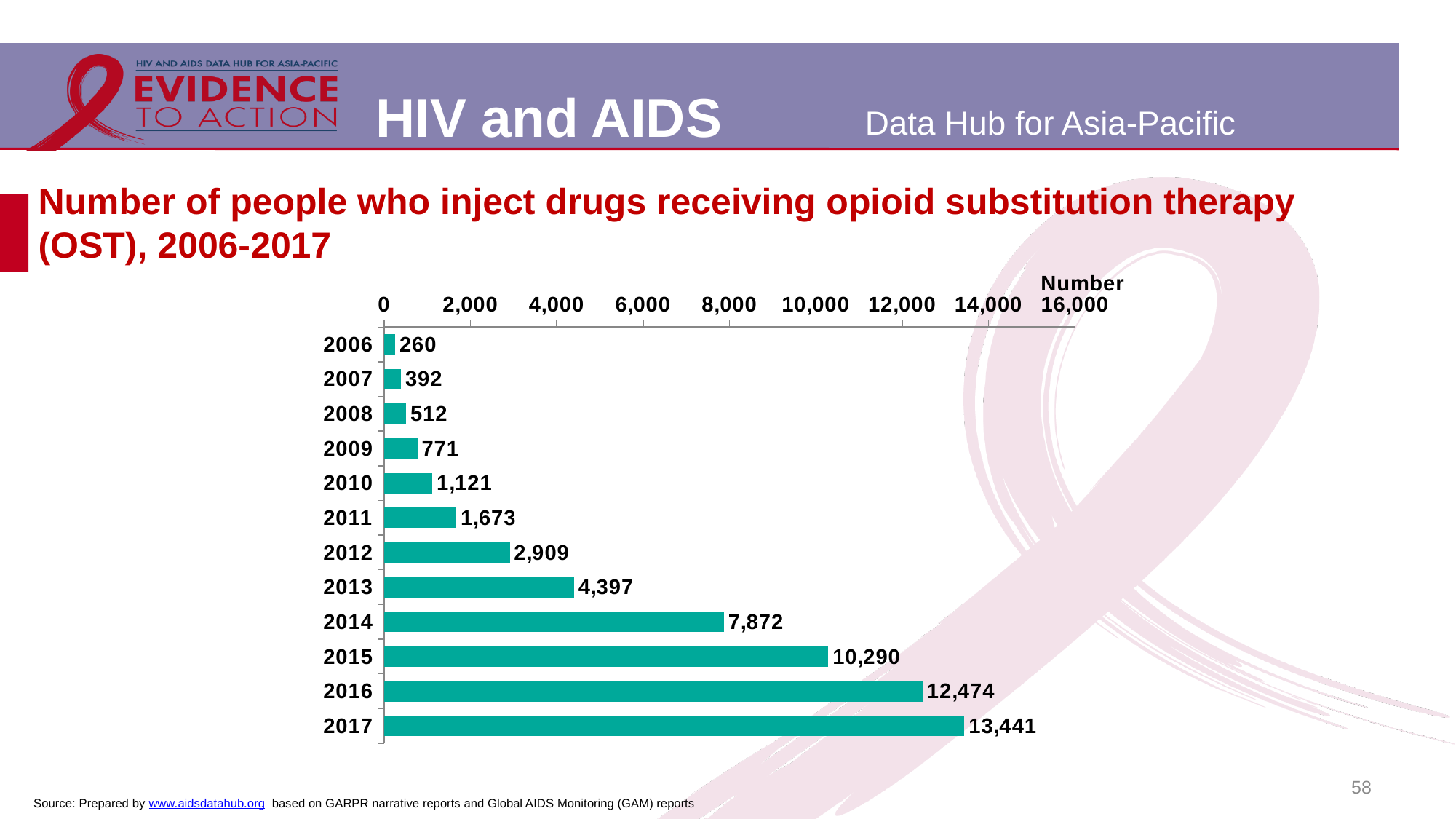
What type of chart is shown on the slide? Bar chart What is the difference between the values for 2015 and 2014? 2,418 What is the value shown for 2010? 1,121 Which year has the lowest number of people receiving OST? 2006 What is the number of people who inject drugs receiving OST in 2014? 7,872 Which year has a larger value, 2012 or 2013? 2013 Do the values rise or fall from 2006 to 2017? Rise How many years are shown in the chart? 12 Which year has the highest number of people receiving OST? 2017 What is the difference between the values for 2017 and 2016? 967 Is the value for 2016 greater or less than 12,000? greater What is the label of the value axis at the top of the chart? Number